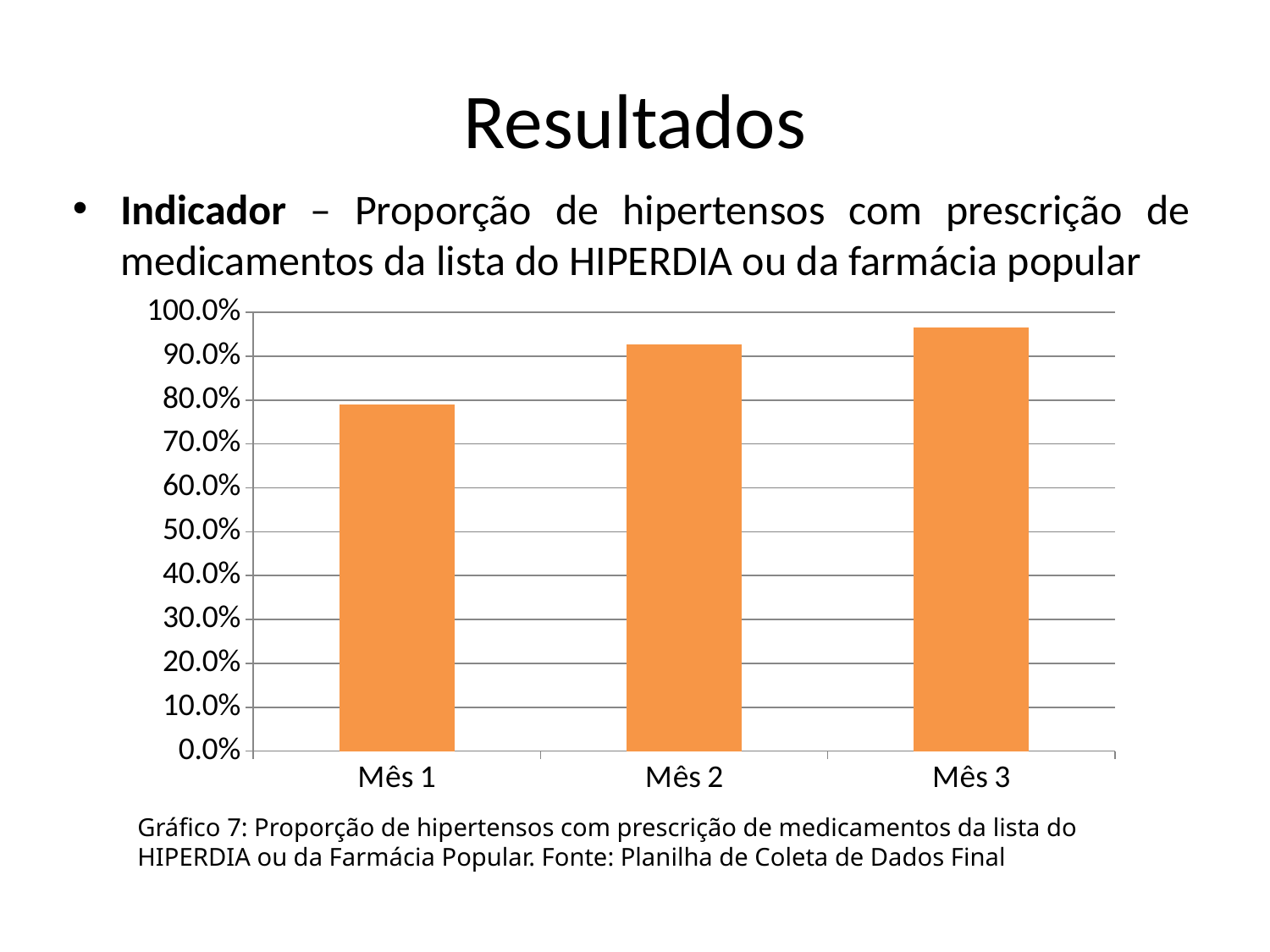
How many categories (months) are plotted on the chart? 3 Which month has the lowest proportion on the chart? Mês 1 Which month has the highest proportion on the chart? Mês 3 What is the number of the graph given in the caption below the chart? Gráfico 7 Is the value for Mês 1 greater or less than 70.0%? greater Is the value for Mês 2 greater or less than 90.0%? greater Is the value for Mês 3 greater or less than 100.0%? less What colour are the bars in the chart? orange Do the values rise or fall from Mês 1 to Mês 3? rise Which is larger, the value for Mês 1 or the value for Mês 2? Mês 2 Which is larger, the value for Mês 2 or the value for Mês 3? Mês 3 What kind of chart is shown on the slide? bar chart